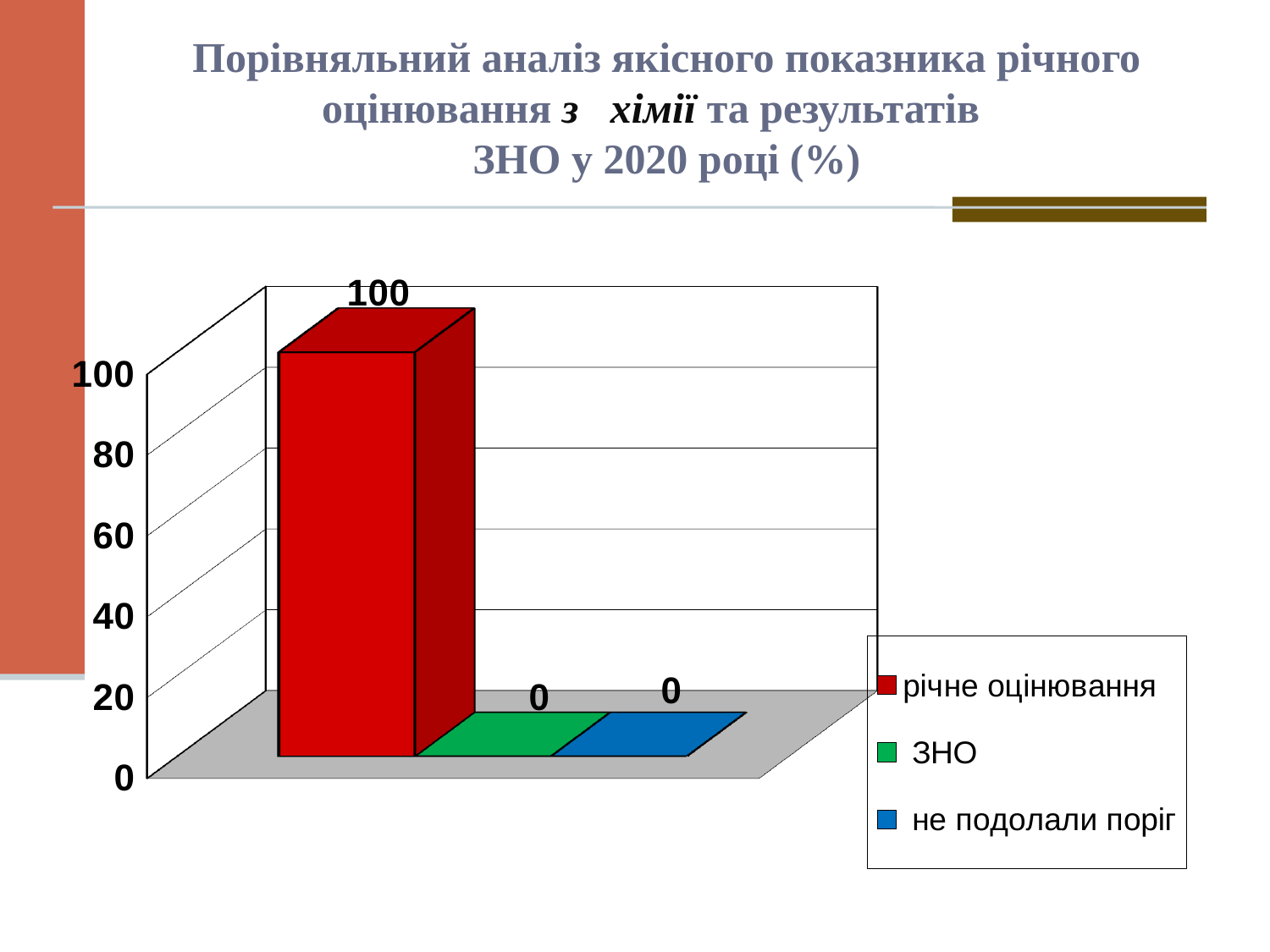
How many series does the legend list? 3 Which series has the highest value? річне оцінювання What is the difference between the value for річне оцінювання and the value for ЗНО? 100 What is the value for не подолали поріг? 0 What kind of chart is shown on the slide? bar chart Which is larger, the value for річне оцінювання or the value for не подолали поріг? річне оцінювання What is the highest value shown on the vertical axis? 100 What colour is the bar for річне оцінювання? red What is the value for ЗНО? 0 What is the value for річне оцінювання? 100 Is the value for річне оцінювання greater or less than 80? greater